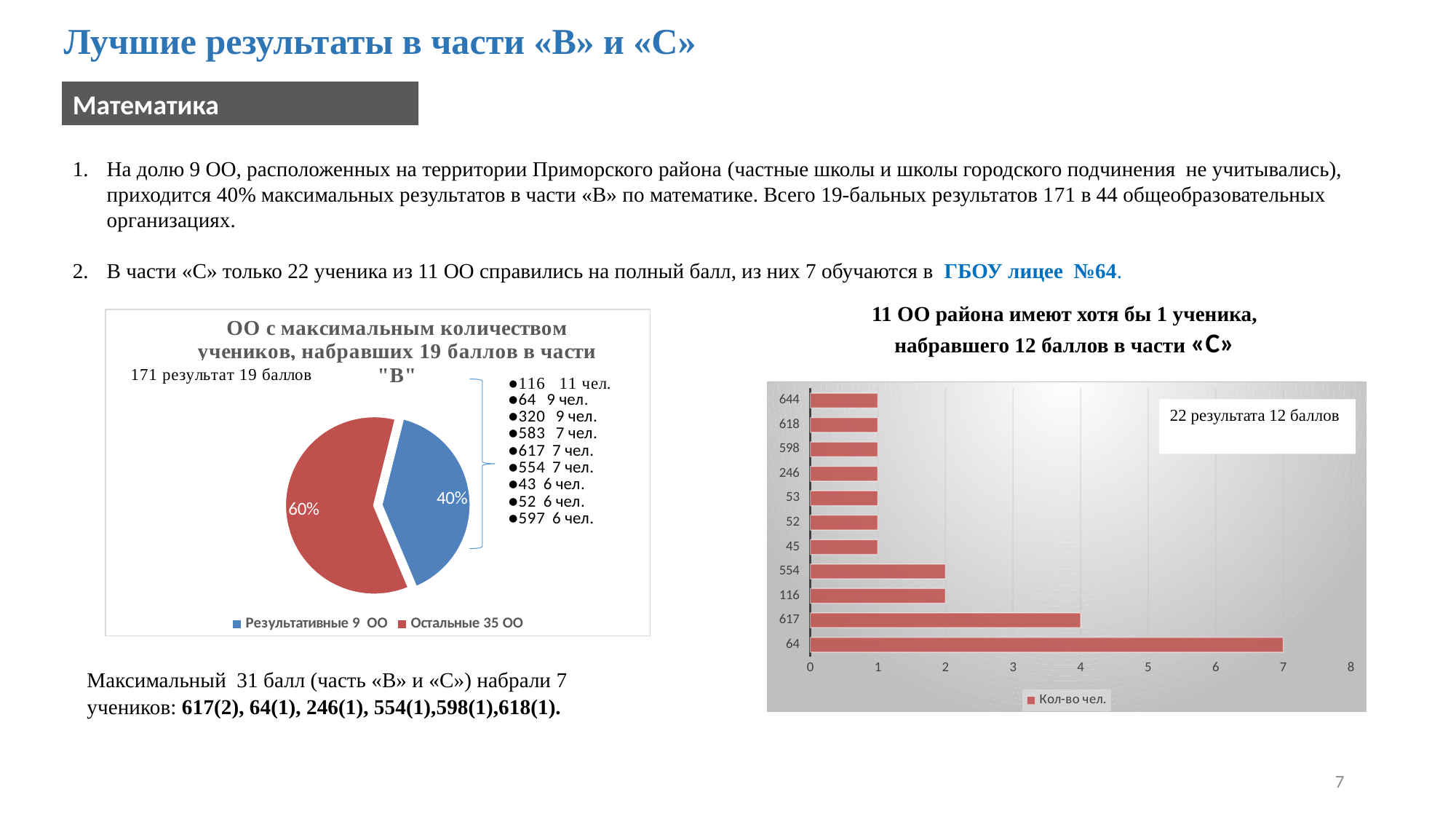
In the bar chart on the right, what is the value for category 617? 4 How many slices does the pie chart on the left have? 2 In the pie chart on the left, what share is shown for "Остальные 35 ОО"? 60% How many series does the legend of the bar chart on the right list? 1 In the bar chart on the right, which category has the highest value? 64 In the bar chart on the right, what is the value for category 64? 7 What kind of chart is the chart on the right of the slide? bar chart In the pie chart on the left, what share is shown for "Результативные 9 ОО"? 40% How many categories are shown in the bar chart on the right? 11 In the bar chart on the right, what is the difference between the values for 64 and 617? 3 What kind of chart is the chart on the left of the slide? pie chart In the pie chart on the left, which slice is larger: "Результативные 9 ОО" or "Остальные 35 ОО"? Остальные 35 ОО